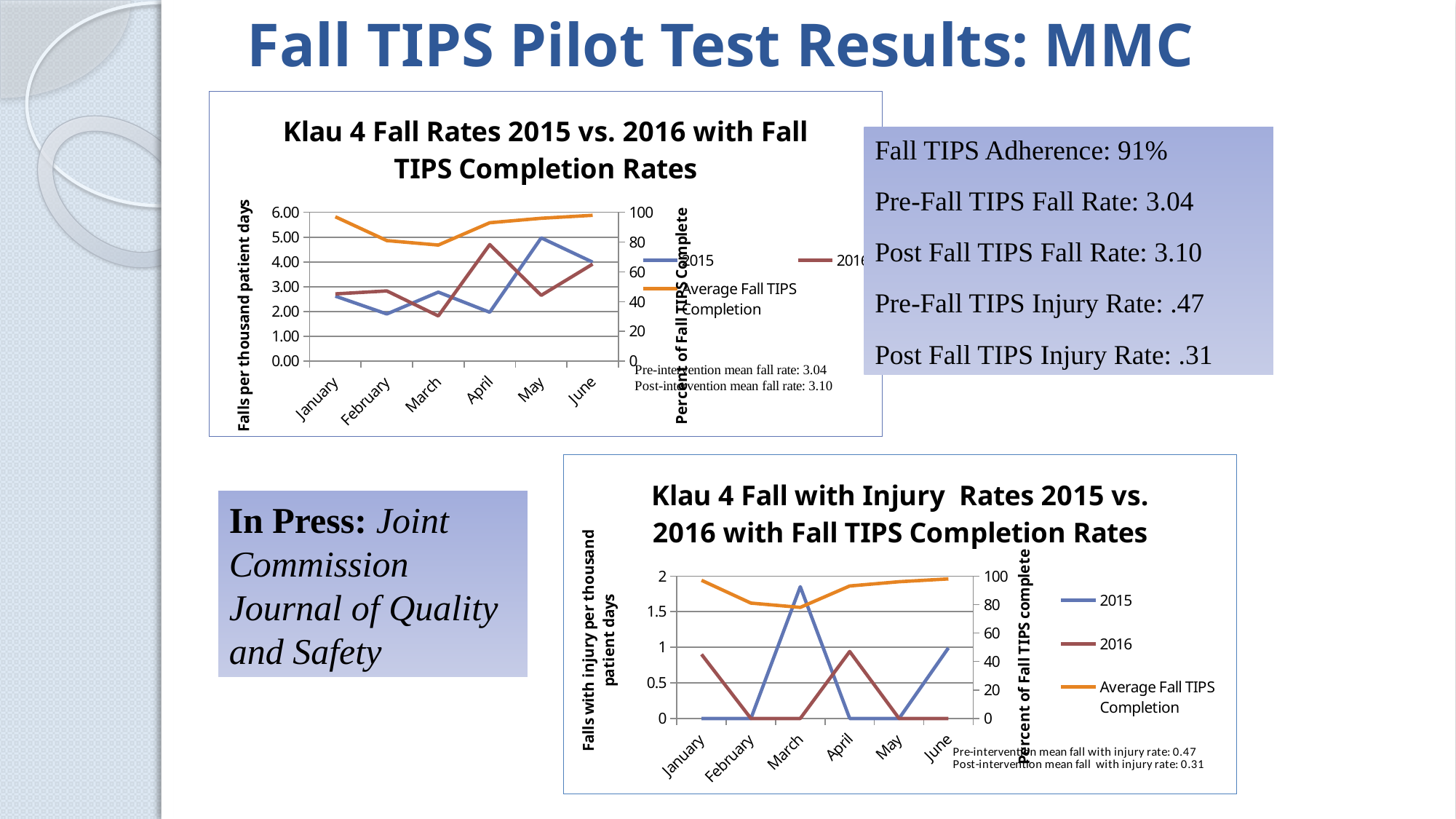
In the bottom chart 'Klau 4 Fall with Injury Rates 2015 vs. 2016', is the 2015 value in March greater or less than 1.5? greater In the top chart 'Klau 4 Fall Rates 2015 vs. 2016', how many months are shown on the x axis? 6 In the bottom chart 'Klau 4 Fall with Injury Rates 2015 vs. 2016', what is the 2015 fall with injury rate in January? 0 In the top chart 'Klau 4 Fall Rates 2015 vs. 2016', how many series does the legend list? 3 In the top chart 'Klau 4 Fall Rates 2015 vs. 2016', in which month is the 2016 fall rate highest? April In the top chart 'Klau 4 Fall Rates 2015 vs. 2016', in which month is the 2015 fall rate highest? May In the bottom chart 'Klau 4 Fall with Injury Rates 2015 vs. 2016', in which month is the 2015 fall with injury rate highest? March What kind of chart is the top chart, 'Klau 4 Fall Rates 2015 vs. 2016 with Fall TIPS Completion Rates'? Line chart In the bottom chart 'Klau 4 Fall with Injury Rates 2015 vs. 2016', what is the 2016 fall with injury rate in February? 0 In the top chart 'Klau 4 Fall Rates 2015 vs. 2016', is the Average Fall TIPS Completion value in January greater or less than 80? greater In the top chart 'Klau 4 Fall Rates 2015 vs. 2016', is the 2016 fall rate in April greater or less than 4.00? greater In the top chart 'Klau 4 Fall Rates 2015 vs. 2016', which series has the larger value in April, 2015 or 2016? 2016